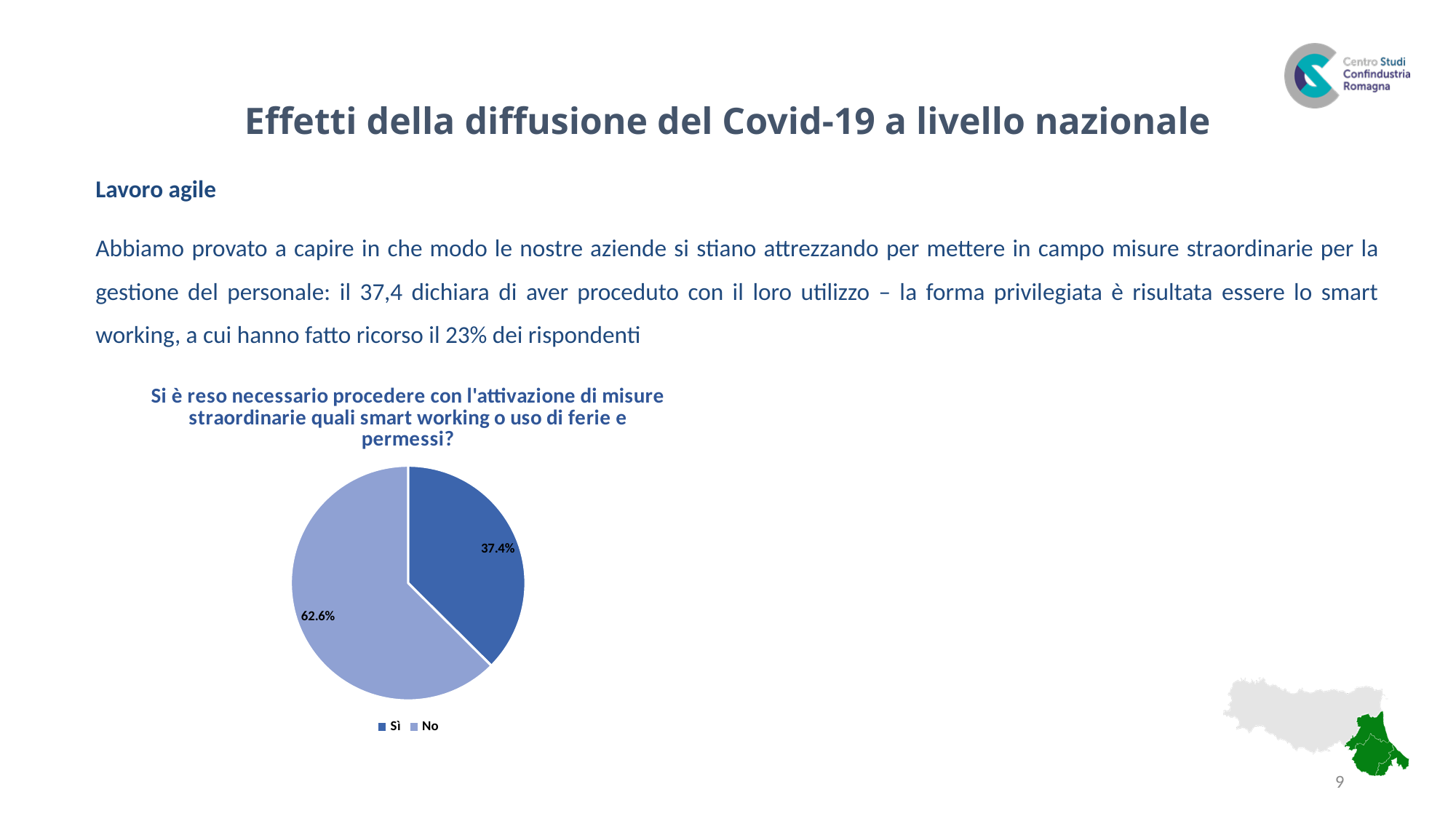
Which slice of the pie is the largest? No Which legend entry is shown in the darker blue colour? Sì What kind of chart is shown on the slide? pie chart How many slices does the pie chart have? 2 What is the title of the pie chart? Si è reso necessario procedere con l'attivazione di misure straordinarie quali smart working o uso di ferie e permessi? Which slice of the pie is the smallest? Sì How many entries does the legend list? 2 Which is larger, the "Sì" slice or the "No" slice? No What share of the pie is labelled "Sì"? 37.4% What is the difference in percentage points between the "No" slice and the "Sì" slice? 25.2 What share of the pie is labelled "No"? 62.6%